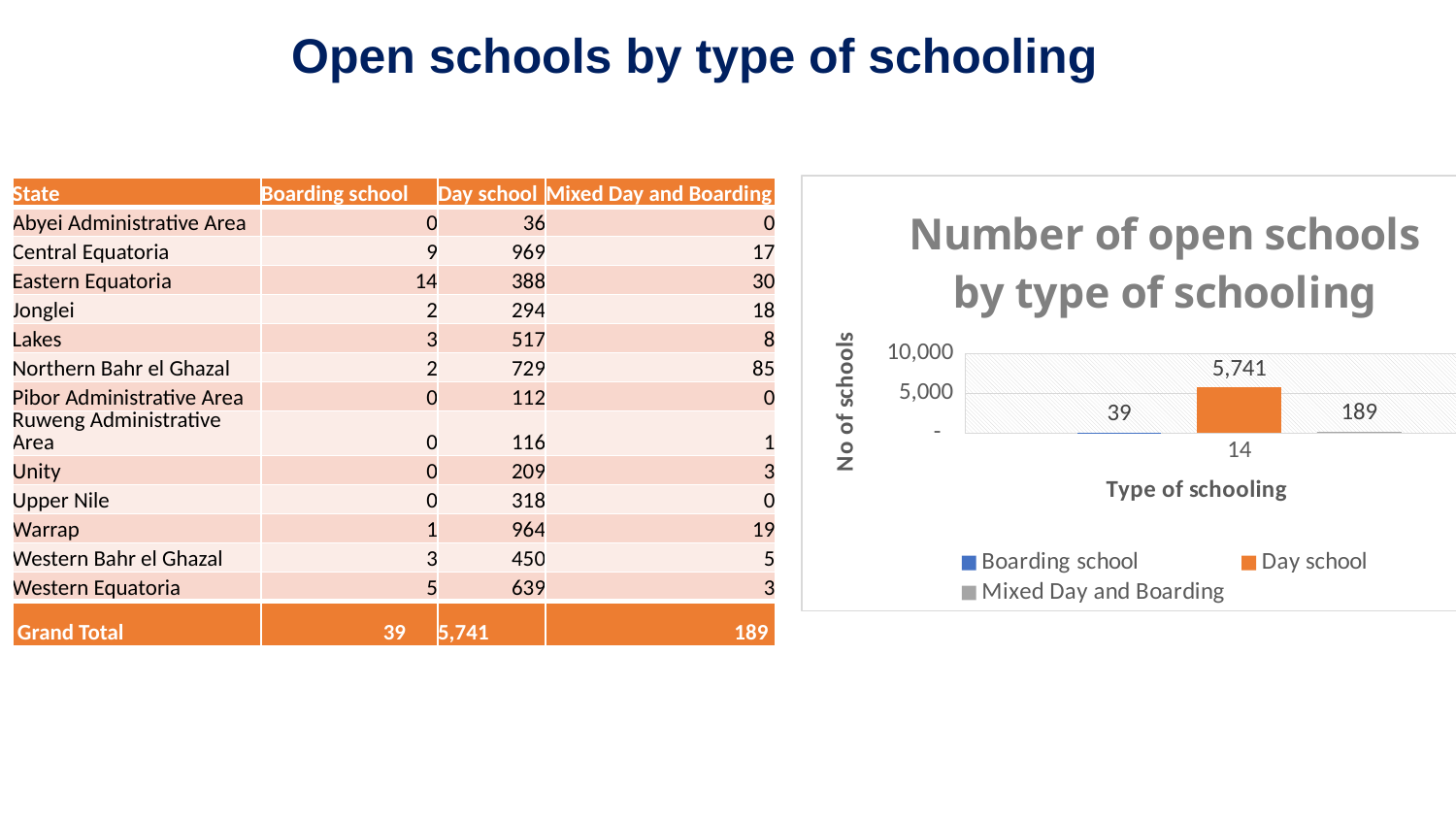
What is the title of the chart on the slide? Number of open schools by type of schooling What is the difference between the Day school value and the Mixed Day and Boarding value in the chart? 5,552 Which is larger in the chart, Mixed Day and Boarding or Boarding school? Mixed Day and Boarding Is the value for Day school in the chart greater or less than 5,000? greater Which series has the lowest value in the chart? Boarding school What type of chart is shown on the slide? bar chart What is the value for Mixed Day and Boarding in the chart? 189 What is the value for Boarding school in the chart? 39 What is the value for Day school in the chart? 5,741 What is the label on the vertical axis of the chart? No of schools How many series does the chart legend list? 3 Which series has the highest value in the chart? Day school